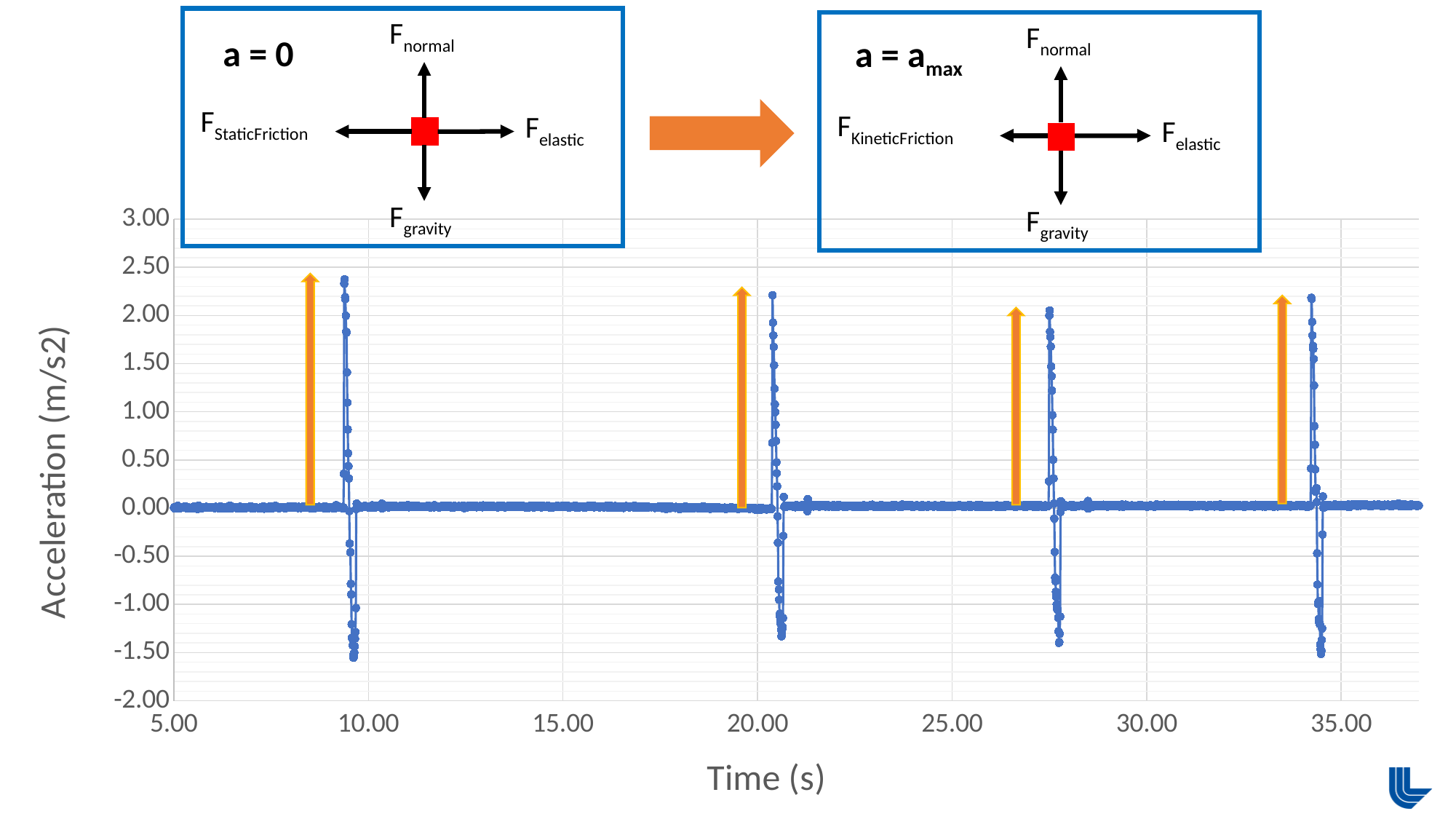
Which spike reaches the highest acceleration of all four? the first spike (near 9.5 s) Which spike reaches the highest acceleration: the first one (near 9.5 s) or the third one (near 27.5 s)? the first one (near 9.5 s) What is the label of the vertical axis of the chart? Acceleration (m/s2) Is the lowest acceleration reached in the first spike (near 9.5 s) greater or less than -1.00 m/s2? less Is the acceleration between the spikes (for example at 15.00 s) greater or less than 0.50 m/s2? less What is the label of the horizontal axis of the chart? Time (s) Is the peak acceleration of the first spike (near 9.5 s) greater or less than 2.00 m/s2? greater What kind of chart is shown on the slide? scatter chart How many large acceleration spikes are plotted in the chart? 4 What is the highest value shown on the vertical axis of the chart? 3.00